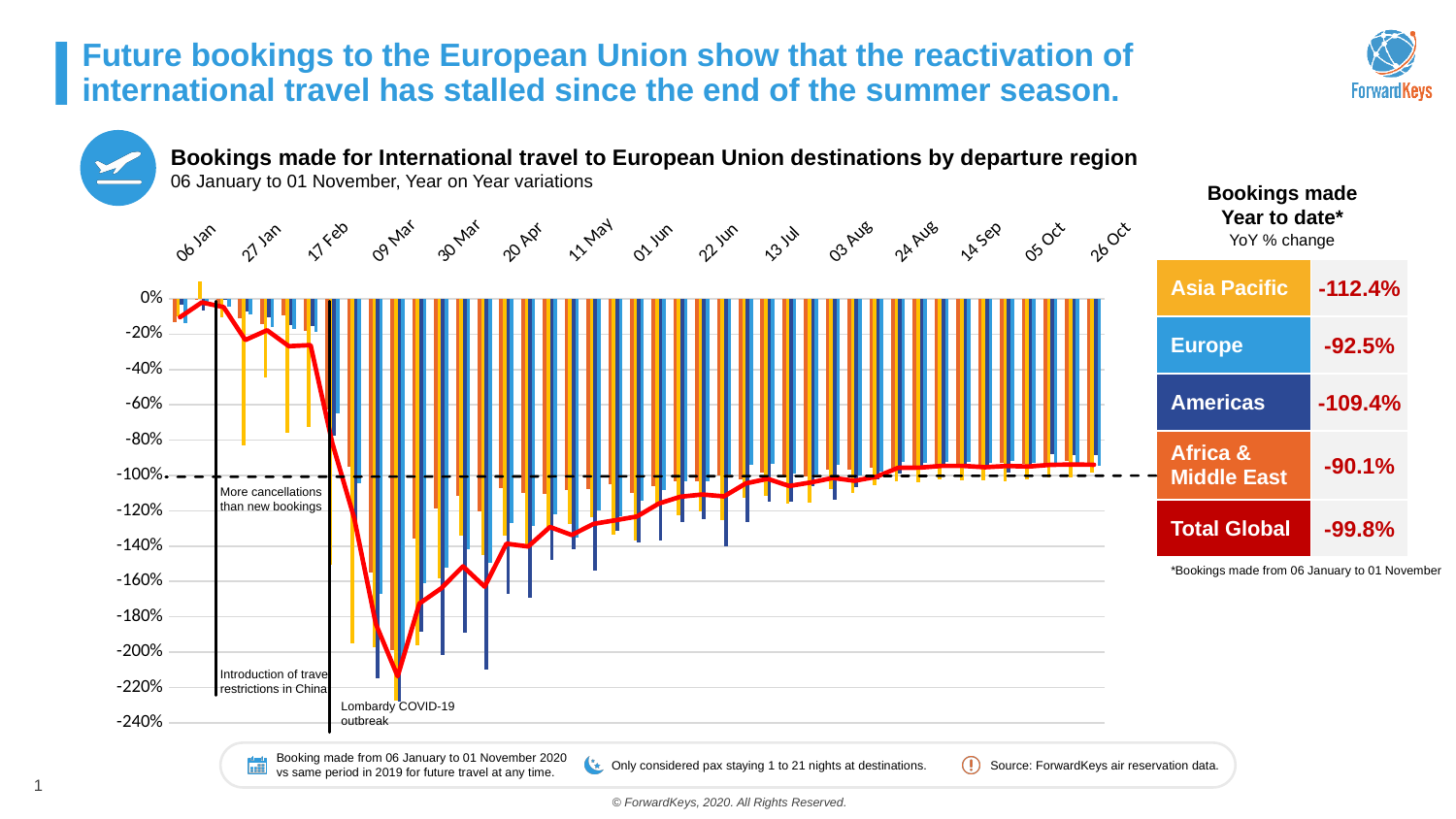
What is the Year to date YoY % change in bookings made for Europe? -92.5% What kind of chart is used to show bookings made for international travel to European Union destinations by departure region? Bar chart with a line Does the Total Global line rise or fall between 09 Mar and 26 Oct? rise Which departure region has the lowest (most negative) Year to date YoY % change? Asia Pacific At what value is the horizontal dashed line drawn on the chart? -100% What is the difference between the Year to date YoY % change for Europe and for Africa & Middle East? 2.4 percentage points What is the Year to date YoY % change in bookings made for the Americas? -109.4% Which has a more negative Year to date YoY % change, the Americas or Europe? Americas Which departure region has the highest (least negative) Year to date YoY % change? Africa & Middle East What is the Year to date YoY % change in bookings made for Asia Pacific? -112.4% What is the Year to date YoY % change in bookings made for Total Global? -99.8%